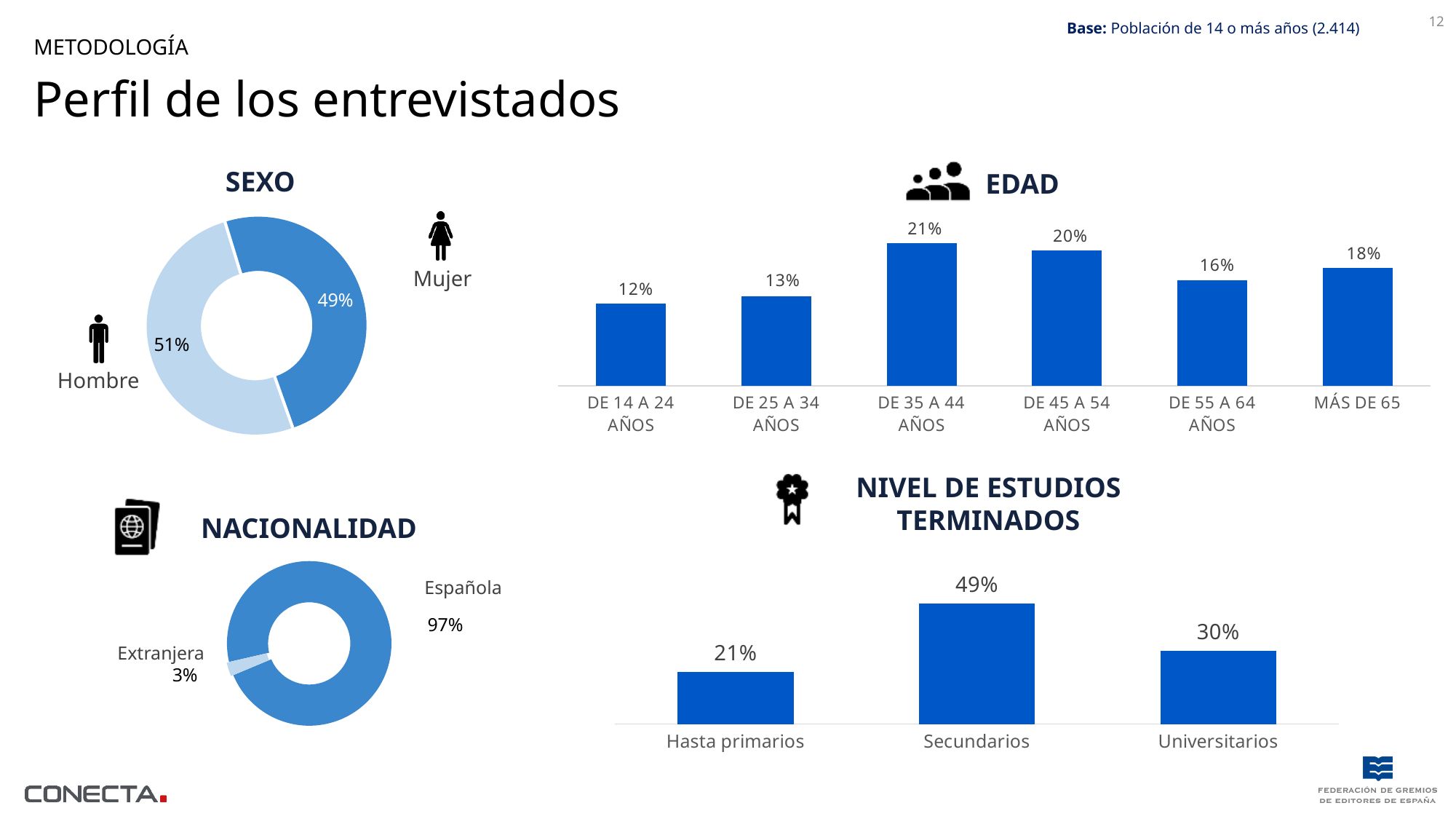
In the NACIONALIDAD chart, what percentage is shown for Española? 97% In the SEXO chart, what percentage is shown for Mujer? 49% In the NIVEL DE ESTUDIOS TERMINADOS chart, what is the difference between Universitarios and Hasta primarios? 9% In the EDAD chart, which age group has the highest value? DE 35 A 44 AÑOS How many age groups are shown in the EDAD chart? 6 In the EDAD chart, what is the difference between DE 45 A 54 AÑOS and DE 55 A 64 AÑOS? 4% In the SEXO chart, what percentage is shown for Hombre? 51% What kind of chart is the SEXO chart? Doughnut chart In the EDAD chart, what is the value for DE 35 A 44 AÑOS? 21% In the EDAD chart, which age group has the lowest value? DE 14 A 24 AÑOS In the NACIONALIDAD chart, what percentage is shown for Extranjera? 3% In the NIVEL DE ESTUDIOS TERMINADOS chart, which category has the highest value? Secundarios